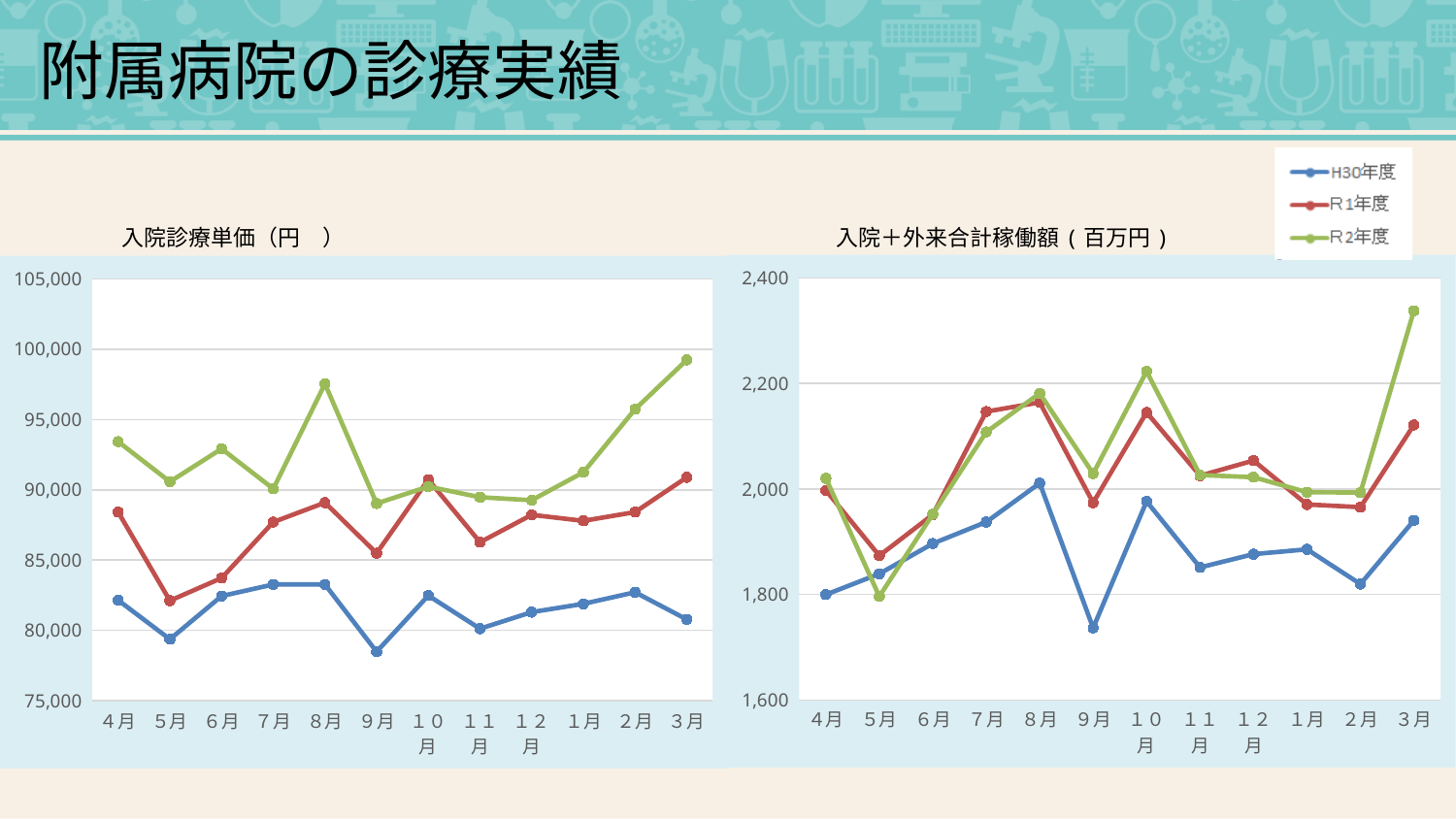
In the left chart titled 入院診療単価（円）, which series has the larger value in 3月, R2年度 or H30年度? R2年度 In the right chart titled 入院＋外来合計稼働額（百万円）, is the value for R2年度 in 10月 greater or less than 2,200? greater In the right chart titled 入院＋外来合計稼働額（百万円）, does the H30年度 series rise or fall from 8月 to 9月? fall In the right chart titled 入院＋外来合計稼働額（百万円）, is the value for H30年度 in 9月 greater or less than 1,800? less In the left chart titled 入院診療単価（円）, is the value for R2年度 in 8月 greater or less than 95,000? greater In the left chart titled 入院診療単価（円）, in which month does the H30年度 series reach its lowest value? 9月 How many months are plotted along the x axis of the right chart titled 入院＋外来合計稼働額（百万円）? 12 How many series does the legend list for the charts on the slide? 3 In the right chart titled 入院＋外来合計稼働額（百万円）, in which month does the R2年度 series reach its highest value? 3月 What kind of chart is the left chart titled 入院診療単価（円）? line chart In the left chart titled 入院診療単価（円）, in which month does the R2年度 series reach its highest value? 3月